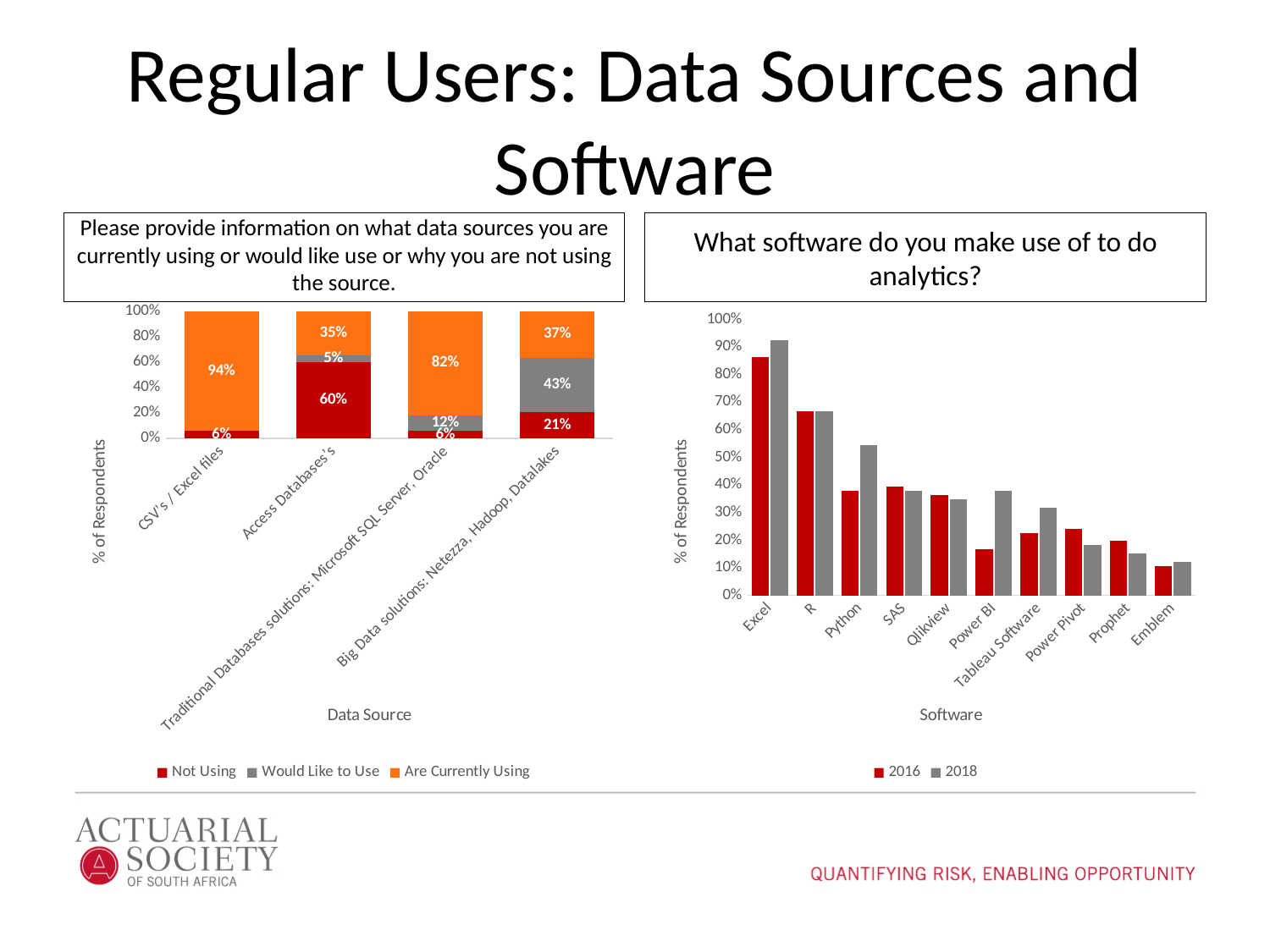
On the right chart (software), how many software categories are shown on the x axis? 10 On the left chart (data sources), which data source has the highest 'Are Currently Using' share? CSV's / Excel files On the right chart (software), which software has the lowest value for 2016? Emblem On the left chart (data sources), what is the difference in percentage points between the 'Are Currently Using' share for Traditional Databases solutions and for Access Databases? 47 percentage points On the left chart (data sources), how many series does the legend list? 3 What kind of chart is the right chart (software)? Bar chart On the right chart (software), which software has the highest value for 2018? Excel On the right chart (software), for Power BI, which year has the larger value, 2016 or 2018? 2018 On the left chart (data sources), what percentage of respondents are currently using CSV's / Excel files? 94% On the right chart (software), is the 2018 value for Python greater or less than 50%? greater On the left chart (data sources), what percentage of respondents are not using Access Databases? 60% On the left chart (data sources), what percentage of respondents would like to use Big Data solutions (Netezza, Hadoop, Datalakes)? 43%